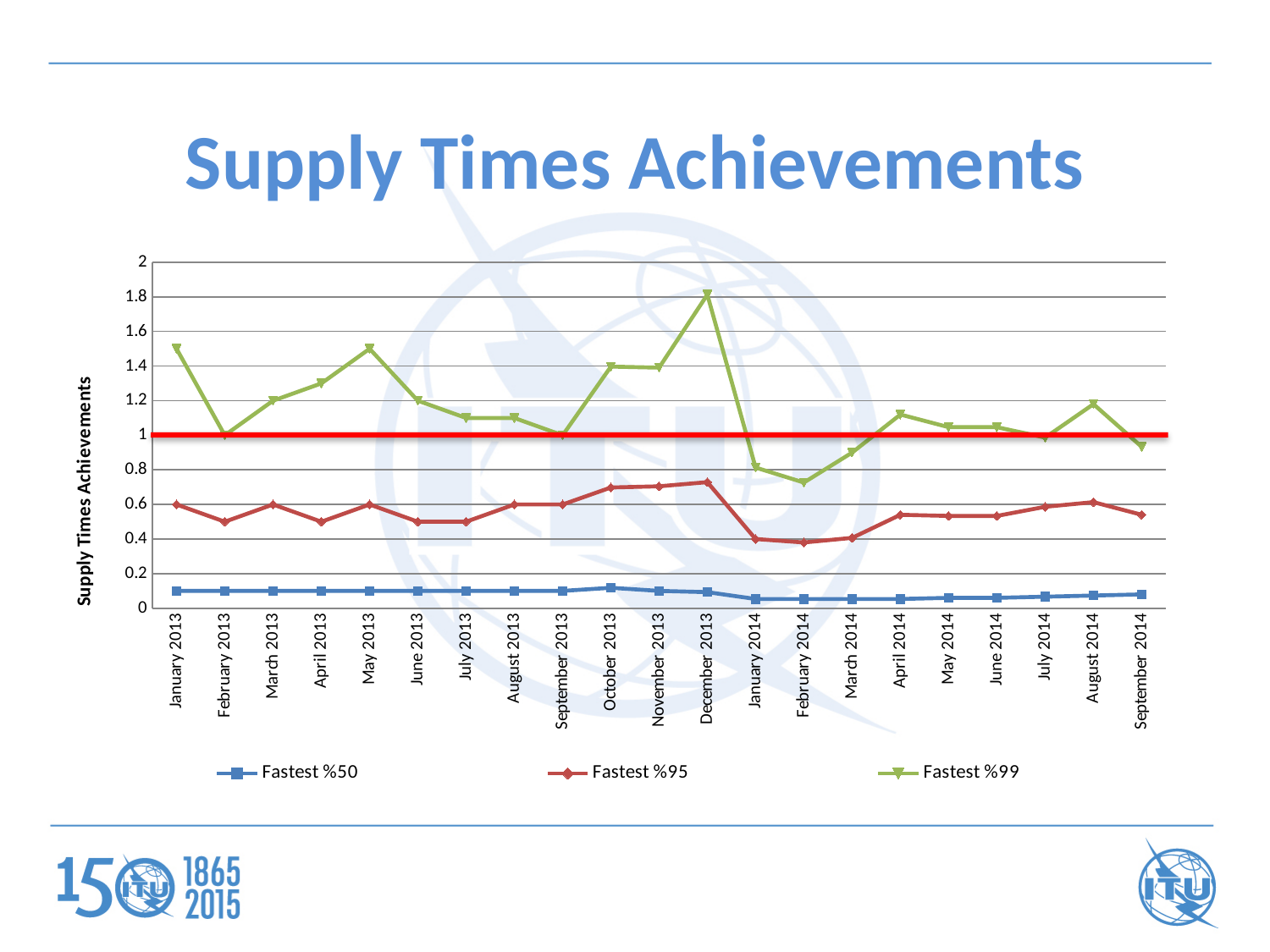
Does the Fastest %99 series rise or fall from December 2013 to February 2014? fall Is the value for Fastest %99 in February 2014 greater or less than 1? less In January 2013, which series has the larger value, Fastest %99 or Fastest %50? Fastest %99 How many series does the legend list? 3 In which month does the Fastest %99 series reach its highest value? December 2013 In which month does the Fastest %99 series reach its lowest value? February 2014 What is the title of the y axis? Supply Times Achievements Is the value for Fastest %95 in January 2013 greater or less than 0.8? less How many months are plotted along the x axis? 21 Is the value for Fastest %99 in December 2013 greater or less than 1.6? greater What kind of chart is shown on the slide? line chart